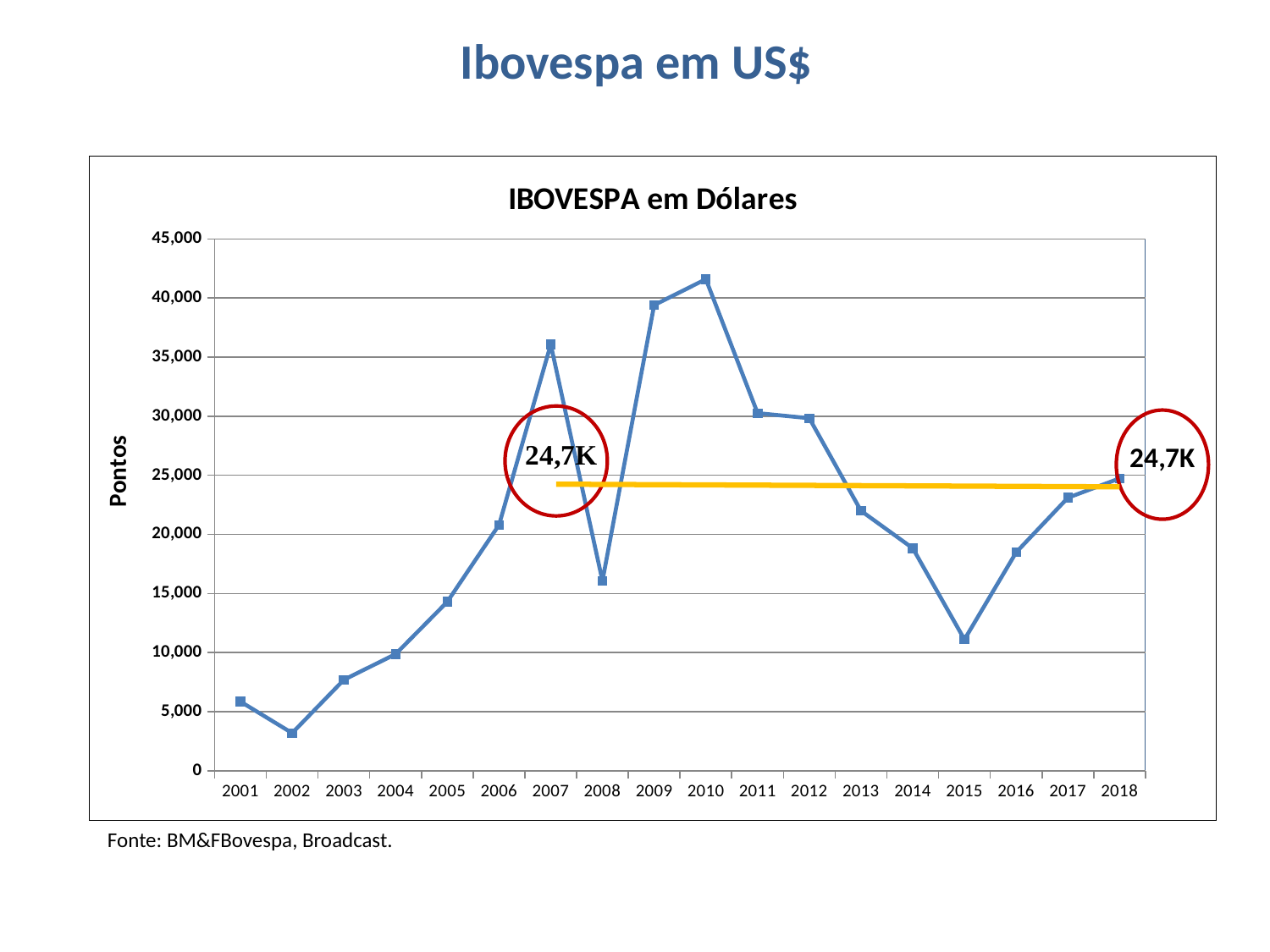
Is the value for 2002 greater or less than 5,000? less Is the value for 2008 greater or less than 20,000? less Which year has the lowest Ibovespa value in dollars? 2002 What is the label on the vertical axis of the chart? Pontos How many years are plotted on the x axis? 18 Do the values rise or fall from 2010 to 2015? fall Which year has the larger value, 2007 or 2008? 2007 What kind of chart is shown on the slide? line chart Which year has the highest Ibovespa value in dollars? 2010 Which year has the larger value, 2009 or 2011? 2009 Is the value for 2015 greater or less than 15,000? less